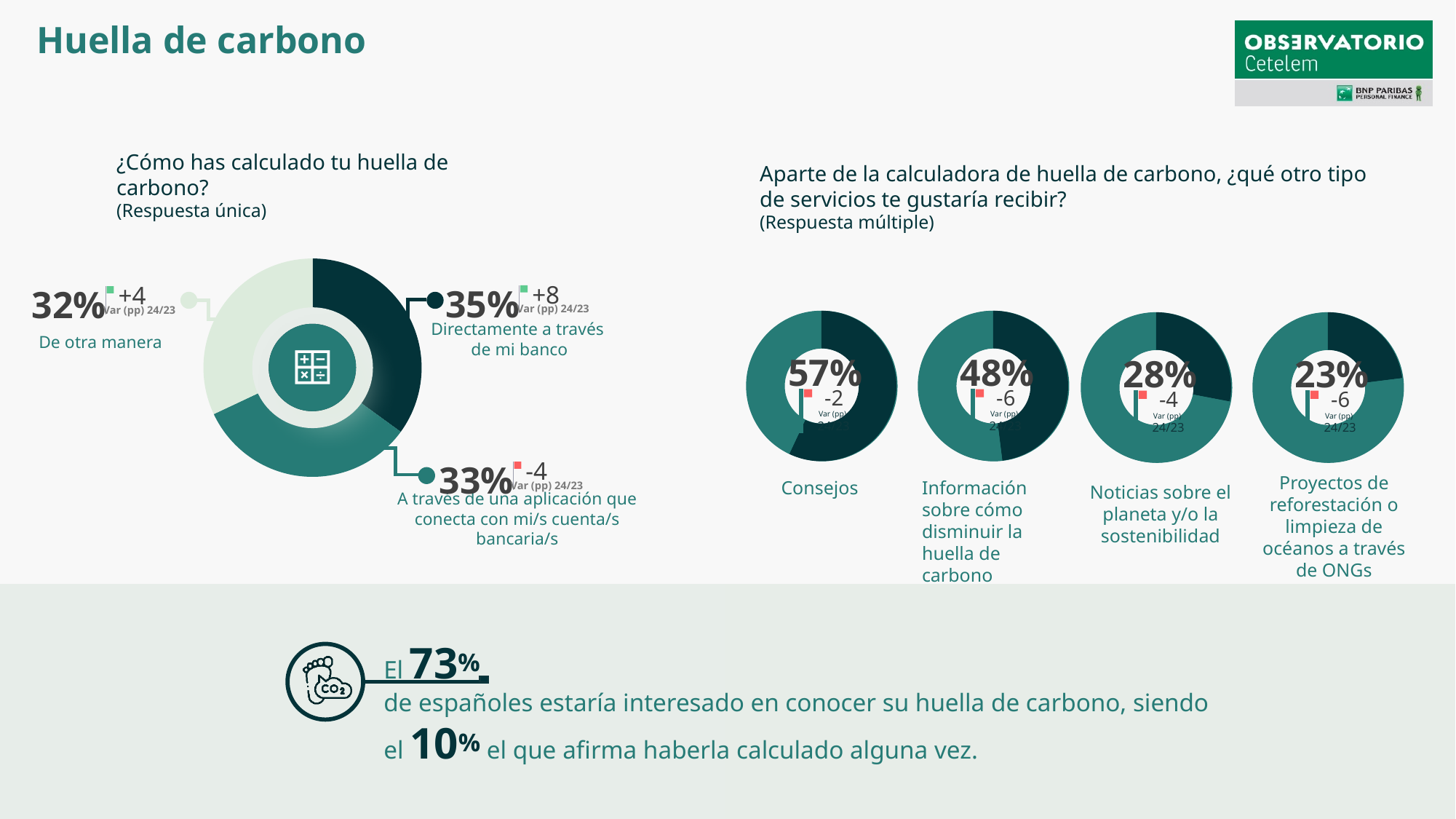
In the chart '¿Cómo has calculado tu huella de carbono?', which option has the highest share? Directamente a través de mi banco In the charts for 'Aparte de la calculadora de huella de carbono, ¿qué otro tipo de servicios te gustaría recibir?', which service has the highest percentage? Consejos In the charts for 'Aparte de la calculadora de huella de carbono, ¿qué otro tipo de servicios te gustaría recibir?', how many services are shown? 4 In the charts for 'Aparte de la calculadora de huella de carbono, ¿qué otro tipo de servicios te gustaría recibir?', what percentage is shown for 'Proyectos de reforestación o limpieza de océanos a través de ONGs'? 23% In the charts for 'Aparte de la calculadora de huella de carbono, ¿qué otro tipo de servicios te gustaría recibir?', what is the difference in percentage points between 'Consejos' and 'Noticias sobre el planeta y/o la sostenibilidad'? 29 In the chart '¿Cómo has calculado tu huella de carbono?', what percentage chose 'Directamente a través de mi banco'? 35% In the chart '¿Cómo has calculado tu huella de carbono?', what is the difference in percentage points between 'Directamente a través de mi banco' and 'De otra manera'? 3 In the chart '¿Cómo has calculado tu huella de carbono?', how many categories are shown? 3 What kind of chart is used for '¿Cómo has calculado tu huella de carbono?'? Donut (pie) chart In the chart '¿Cómo has calculado tu huella de carbono?', which option has the lowest share? De otra manera In the chart '¿Cómo has calculado tu huella de carbono?', what percentage chose 'De otra manera'? 32% In the charts for 'Aparte de la calculadora de huella de carbono, ¿qué otro tipo de servicios te gustaría recibir?', what percentage is shown for 'Consejos'? 57%